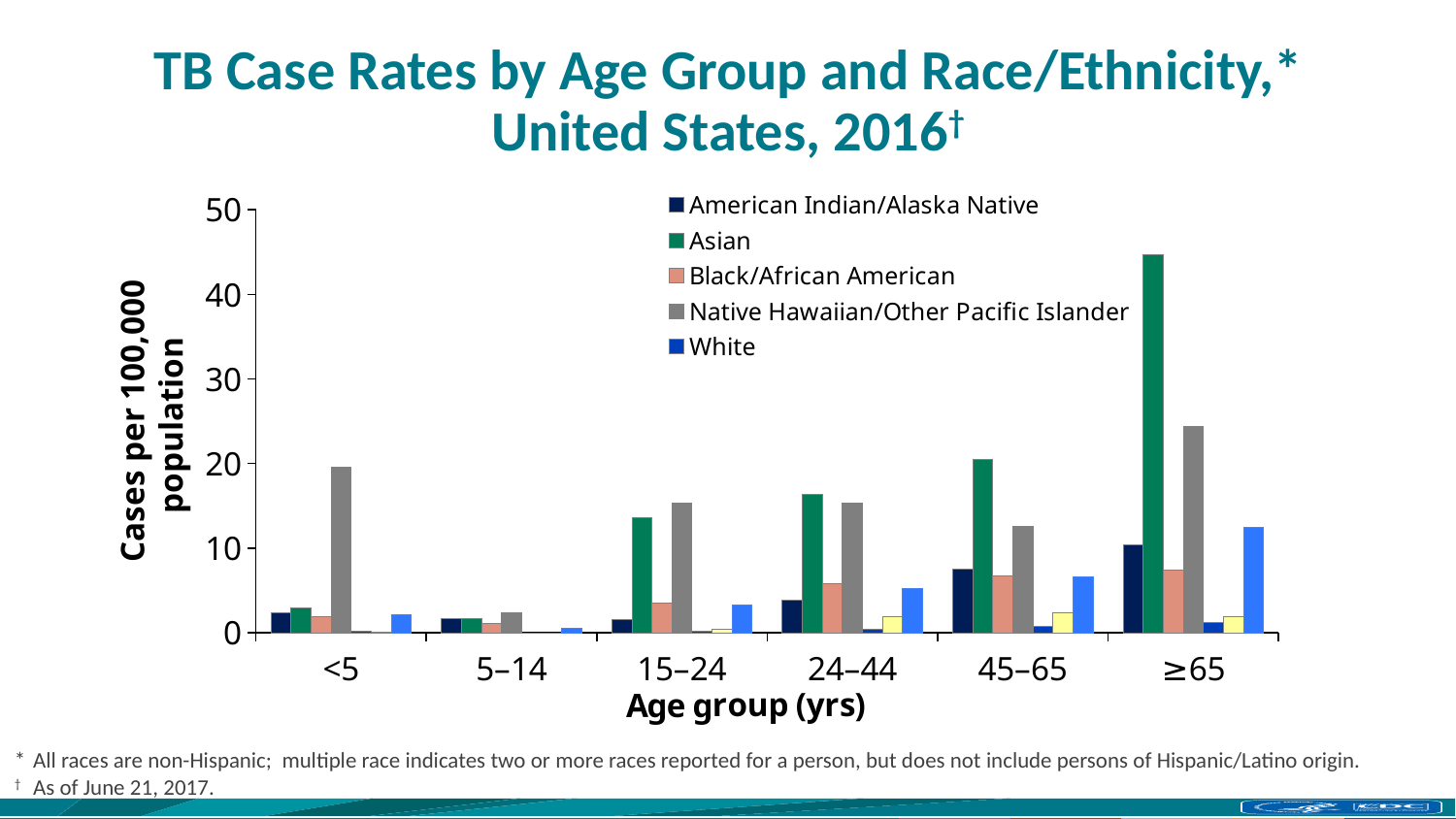
Which age group has the lowest TB case rate for Asian persons? 5–14 Is the Asian case rate for the 24–44 age group greater or less than 20? less Which age group has the highest TB case rate for Asian persons? ≥65 In the ≥65 age group, which is larger: the Asian rate or the Native Hawaiian/Other Pacific Islander rate? Asian Is the Native Hawaiian/Other Pacific Islander case rate for the <5 age group greater or less than 10? greater What kind of chart is shown on the slide? bar chart Is the White case rate for the ≥65 age group greater or less than 10? less What is the label on the y axis? Cases per 100,000 population How many age groups are shown on the x axis? 6 From the 15–24 age group to the ≥65 age group, does the Asian case rate rise or fall? rise How many series does the legend list? 5